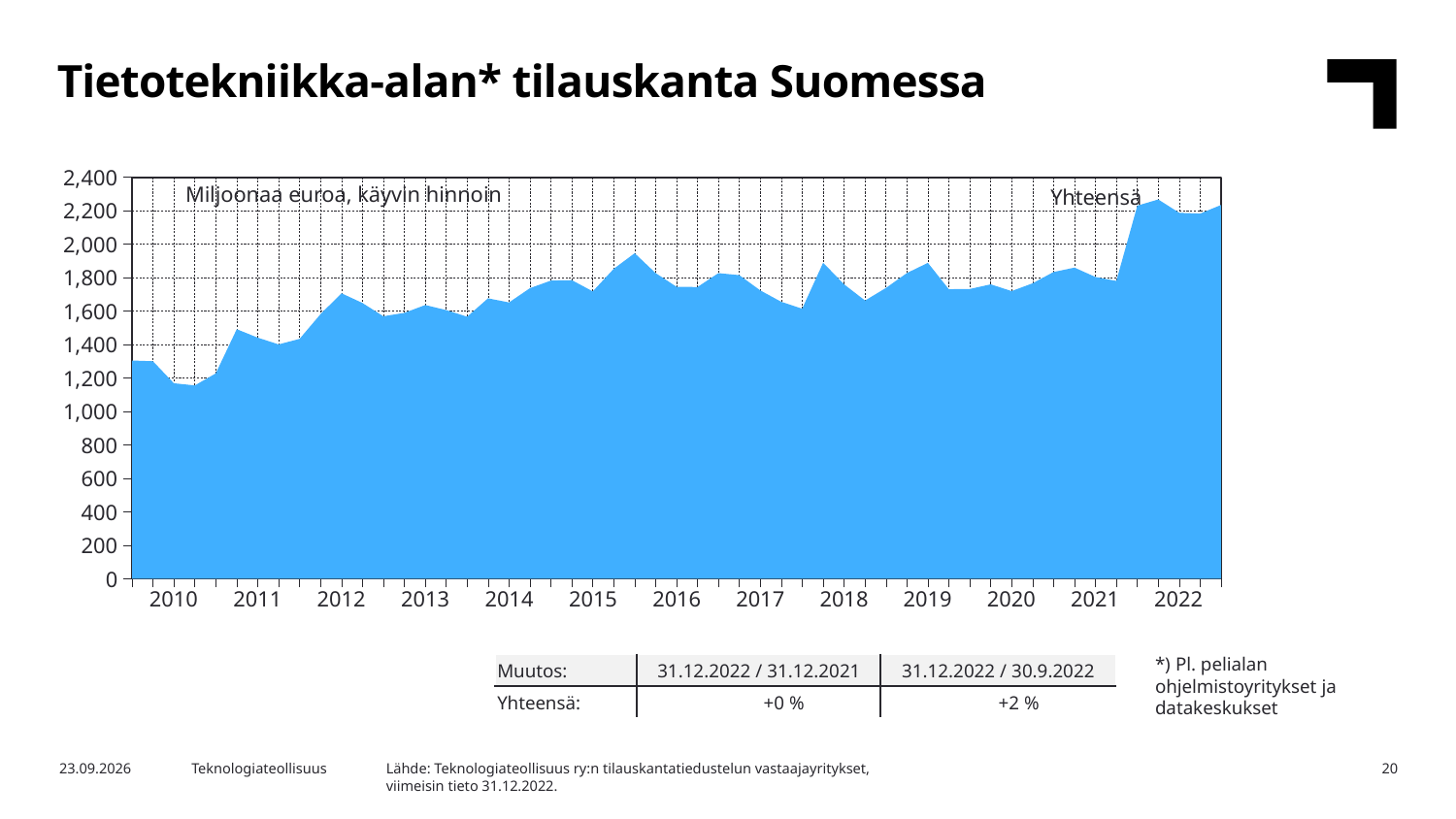
According to the table below the chart, what is the change (Muutos) for Yhteensä between 31.12.2021 and 31.12.2022? +0 % How many data series does the chart show? 1 What is the title of the chart on the slide? Tietotekniikka-alan* tilauskanta Suomessa Is the value at the end of 2022 greater or less than 2,000? greater What unit is the chart's data expressed in, according to the label inside the plot area? Miljoonaa euroa, käyvin hinnoin How many year labels are shown on the x axis? 13 What kind of chart is shown on the slide? Area chart Overall, do the values rise or fall from 2010 to 2022? rise In which year does the chart reach its lowest values? 2010 Is the value at the start of 2013 greater or less than 1,400? greater In which year does the chart reach its highest values? 2022 Is the peak value in 2015 greater or less than 2,000? less